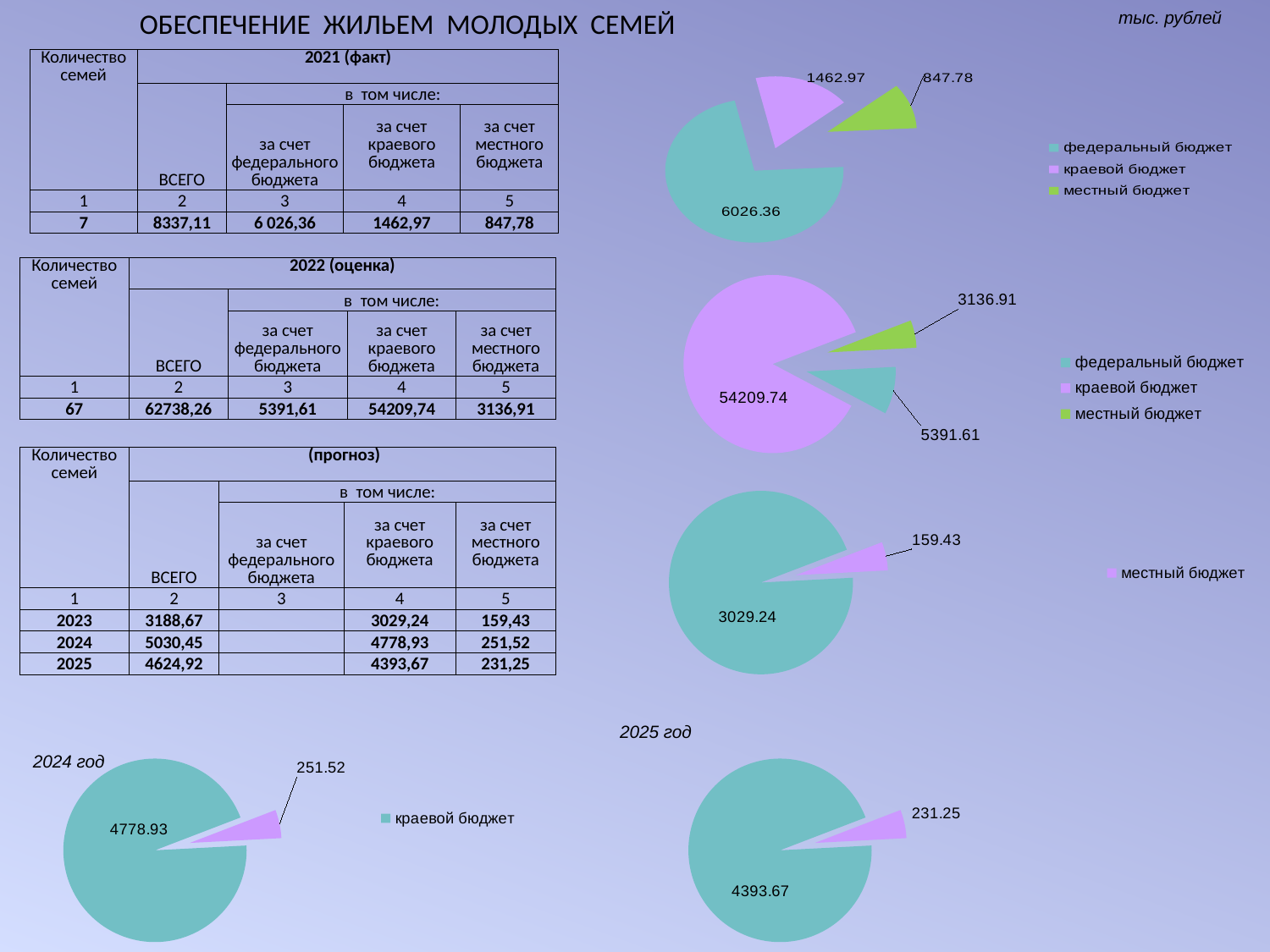
What legend entry is shown next to the bottom-left pie chart labelled '2024 год'? краевой бюджет In the bottom-left pie chart labelled '2024 год', what is the difference between the two slice values? 4527.41 In the bottom-right pie chart labelled '2025 год', what is the total of the two slice values? 4624.92 In the second pie chart from the top on the right, which slice is the largest? краевой бюджет In the bottom-right pie chart labelled '2025 год', what is the value of the smaller slice? 231.25 What kind of chart is the bottom-left chart labelled '2024 год'? pie chart How many entries does the legend of the top-right pie chart list? 3 In the top-right pie chart, what is the value of the 'федеральный бюджет' slice? 6026.36 In the second pie chart from the top on the right, what is the value of the largest slice? 54209.74 How many slices does the second pie chart from the top on the right have? 3 In the top-right pie chart, which slice is the smallest? местный бюджет In the top-right pie chart, what is the value of the 'местный бюджет' slice? 847.78